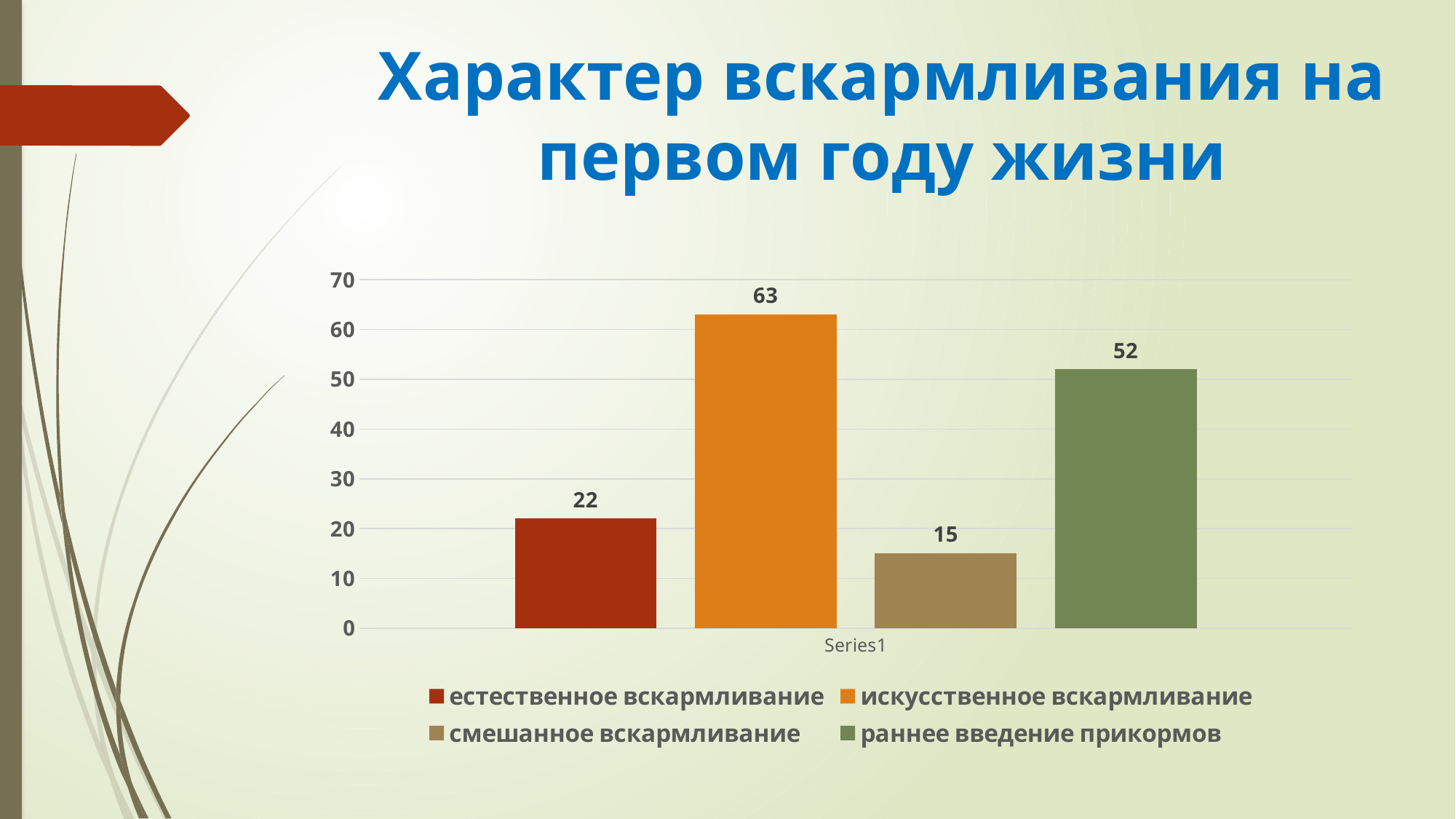
What is the value for искусственное вскармливание? 63 What is the value for раннее введение прикормов? 52 What is the value for смешанное вскармливание? 15 Which category has the lowest value? смешанное вскармливание What is the difference between the values for естественное вскармливание and смешанное вскармливание? 7 What kind of chart is shown on the slide? bar chart What is the title of the slide? Характер вскармливания на первом году жизни How many bars are plotted on the chart? 4 Which is larger, the value for естественное вскармливание or the value for раннее введение прикормов? раннее введение прикормов Which category has the highest value? искусственное вскармливание What is the difference between the values for искусственное вскармливание and раннее введение прикормов? 11 What is the value for естественное вскармливание? 22